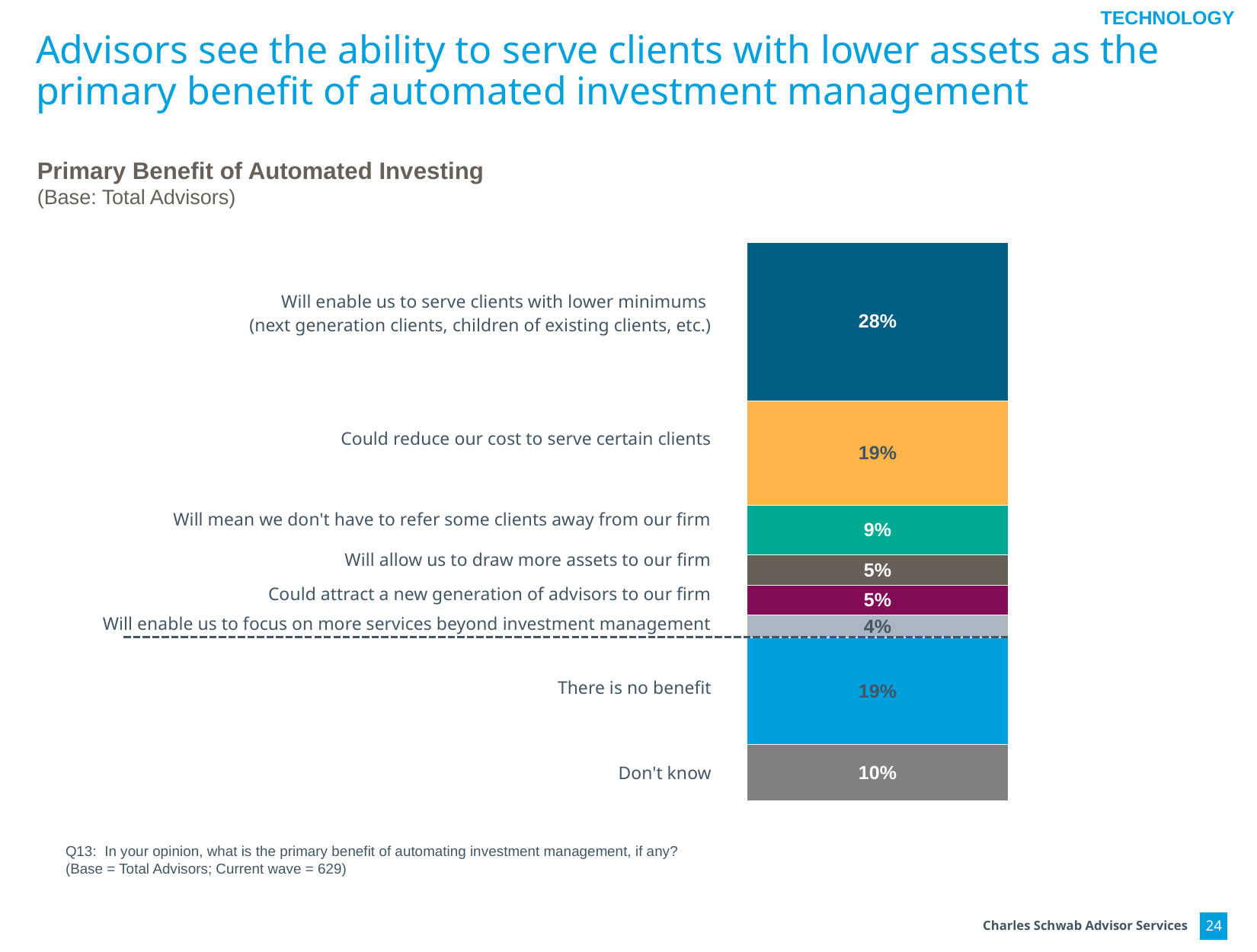
What percentage of advisors said automated investing will enable them to serve clients with lower minimums? 28% What percentage of advisors said automated investing will mean they don't have to refer some clients away from their firm? 9% Which response has the highest percentage in the chart? Will enable us to serve clients with lower minimums What is the title of the chart? Primary Benefit of Automated Investing What kind of chart is shown on the slide? Stacked bar chart Which is larger: the percentage for 'Could reduce our cost to serve certain clients' or for 'Don't know'? Could reduce our cost to serve certain clients How many response categories are shown in the chart? 8 What percentage of advisors answered 'Don't know'? 10% What is the total of all the segments in the stacked bar? 99% What percentage of advisors said there is no benefit to automated investing? 19% Which response has the lowest percentage in the chart? Will enable us to focus on more services beyond investment management How many percentage points higher is 'Will enable us to serve clients with lower minimums' than 'Could reduce our cost to serve certain clients'? 9 percentage points